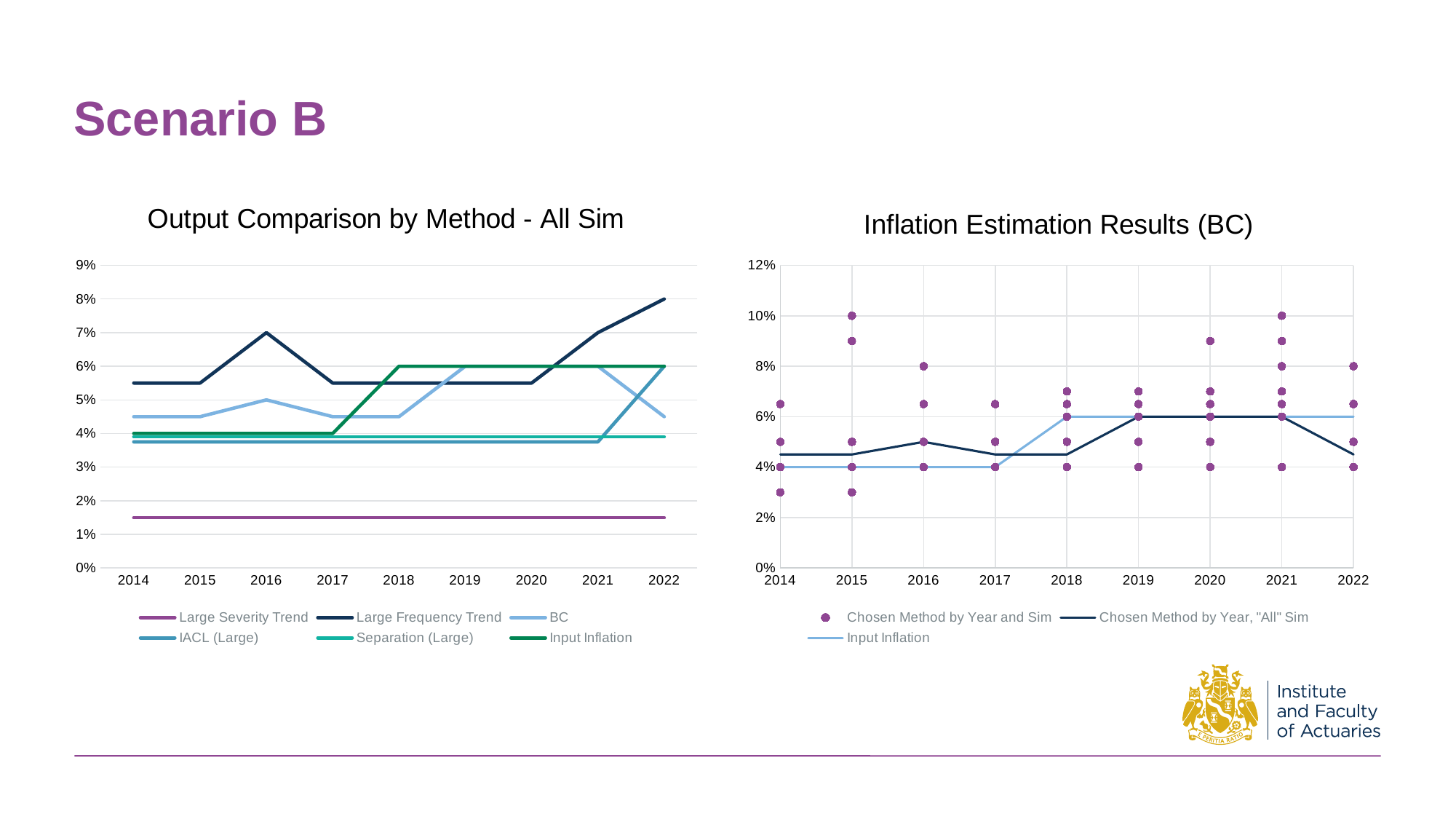
How many years are shown on the x axis of the 'Output Comparison by Method - All Sim' chart? 9 How many series does the legend of the 'Output Comparison by Method - All Sim' chart list? 6 In the 'Inflation Estimation Results (BC)' chart, what is the value of Input Inflation in 2022? 6% In the 'Output Comparison by Method - All Sim' chart, what is the value of Large Frequency Trend in 2022? 8% In the 'Output Comparison by Method - All Sim' chart, what is the value of Large Frequency Trend in 2016? 7% In the 'Inflation Estimation Results (BC)' chart, what is the value of Input Inflation in 2014? 4% In the 'Output Comparison by Method - All Sim' chart, is the value for Large Severity Trend in 2014 greater or less than 2%? less What kind of chart is the 'Output Comparison by Method - All Sim' chart? line chart In the 'Output Comparison by Method - All Sim' chart, does Large Frequency Trend rise or fall from 2020 to 2022? rise In the 'Output Comparison by Method - All Sim' chart, which is larger in 2016: Large Frequency Trend or BC? Large Frequency Trend How many entries does the legend of the 'Inflation Estimation Results (BC)' chart list? 3 In the 'Output Comparison by Method - All Sim' chart, in which year is Large Frequency Trend highest? 2022